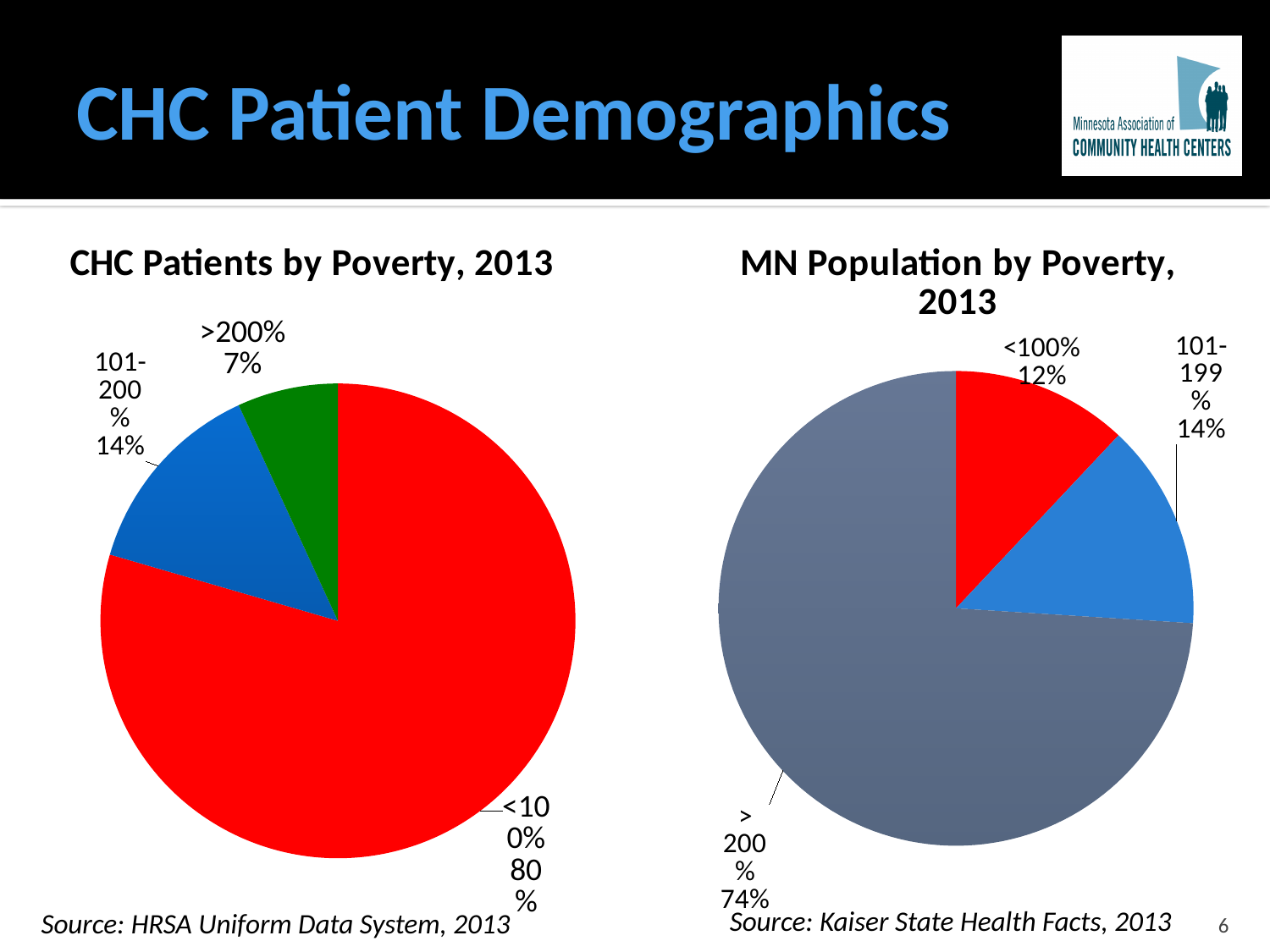
How many slices does the 'CHC Patients by Poverty, 2013' pie chart have? 3 In the 'MN Population by Poverty, 2013' chart, what share of the MN population is in the <100% poverty category? 12% What is the difference between the <100% share in the 'CHC Patients by Poverty, 2013' chart and the <100% share in the 'MN Population by Poverty, 2013' chart? 68 percentage points In the 'CHC Patients by Poverty, 2013' chart, what share of CHC patients are in the <100% poverty category? 80% Which is larger: the >200% share in the 'CHC Patients by Poverty, 2013' chart or the >200% share in the 'MN Population by Poverty, 2013' chart? MN Population by Poverty, 2013 What type of chart is used for 'MN Population by Poverty, 2013'? Pie chart In the 'MN Population by Poverty, 2013' chart, what share of the MN population is in the >200% poverty category? 74% In the 'MN Population by Poverty, 2013' chart, what share of the MN population is in the 101-199% poverty category? 14% In the 'CHC Patients by Poverty, 2013' chart, which poverty category has the largest slice? <100% In the 'CHC Patients by Poverty, 2013' chart, what share of CHC patients are in the 101-200% poverty category? 14% In the 'CHC Patients by Poverty, 2013' chart, what share of CHC patients are in the >200% poverty category? 7% In the 'MN Population by Poverty, 2013' chart, which poverty category has the smallest slice? <100%